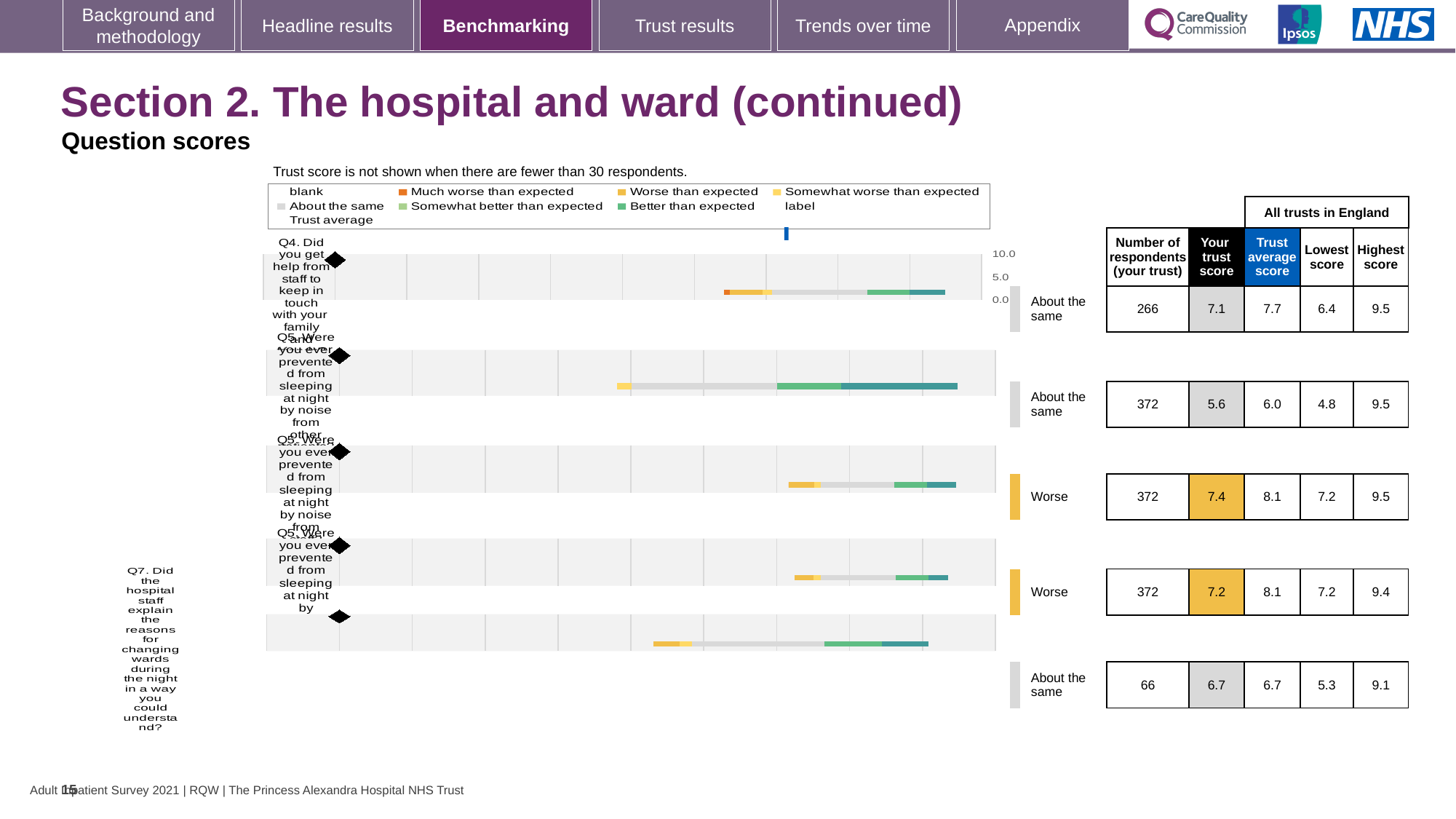
For Q4, which is larger: your trust score or the trust average score? Trust average score Which question row has the fewest respondents (your trust)? Q7 What is the 'Your trust score' value for Q7 (hospital staff explaining reasons for changing wards during the night)? 6.7 What is the 'Your trust score' value in the second row of the table (Q5, noise from other patients)? 5.6 What kind of chart is used to show the question scores on this slide? Bar chart What benchmark category label is shown next to the Q4 bar? About the same What is the difference between the trust average score and your trust score for Q4? 0.6 What is the lowest score across all trusts in England for Q7? 5.3 What is the highest score across all trusts in England for Q7? 9.1 What is the trust average score for Q4? 7.7 What is the 'Your trust score' value for Q4 (help from staff to keep in touch with family and friends)? 7.1 How many respondents (your trust) are shown for Q4? 266